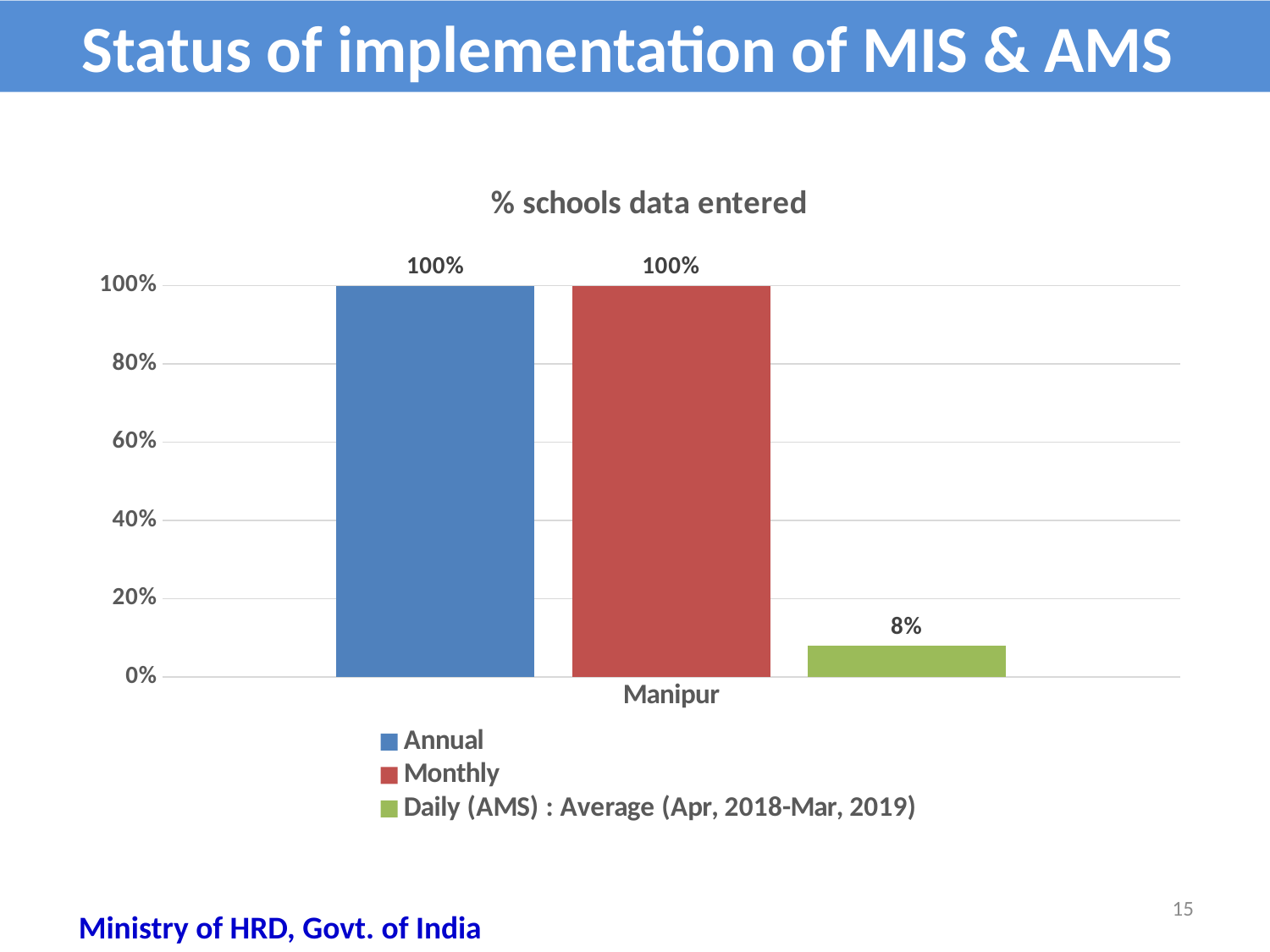
What kind of chart is shown on the slide? bar chart Is the Daily (AMS) value for Manipur greater or less than 20%? less What is the difference between the Annual value and the Daily (AMS) value for Manipur? 92% What is the value of the Annual series for Manipur? 100% Which series has the lowest value for Manipur? Daily (AMS) : Average (Apr, 2018-Mar, 2019) What is the value of the Daily (AMS) : Average (Apr, 2018-Mar, 2019) series for Manipur? 8% How many categories are shown on the x axis? 1 What colour is the bar for the Monthly series? red Which is larger for Manipur, the Monthly value or the Daily (AMS) value? Monthly What is the title of the chart? % schools data entered How many series does the legend list? 3 What is the value of the Monthly series for Manipur? 100%